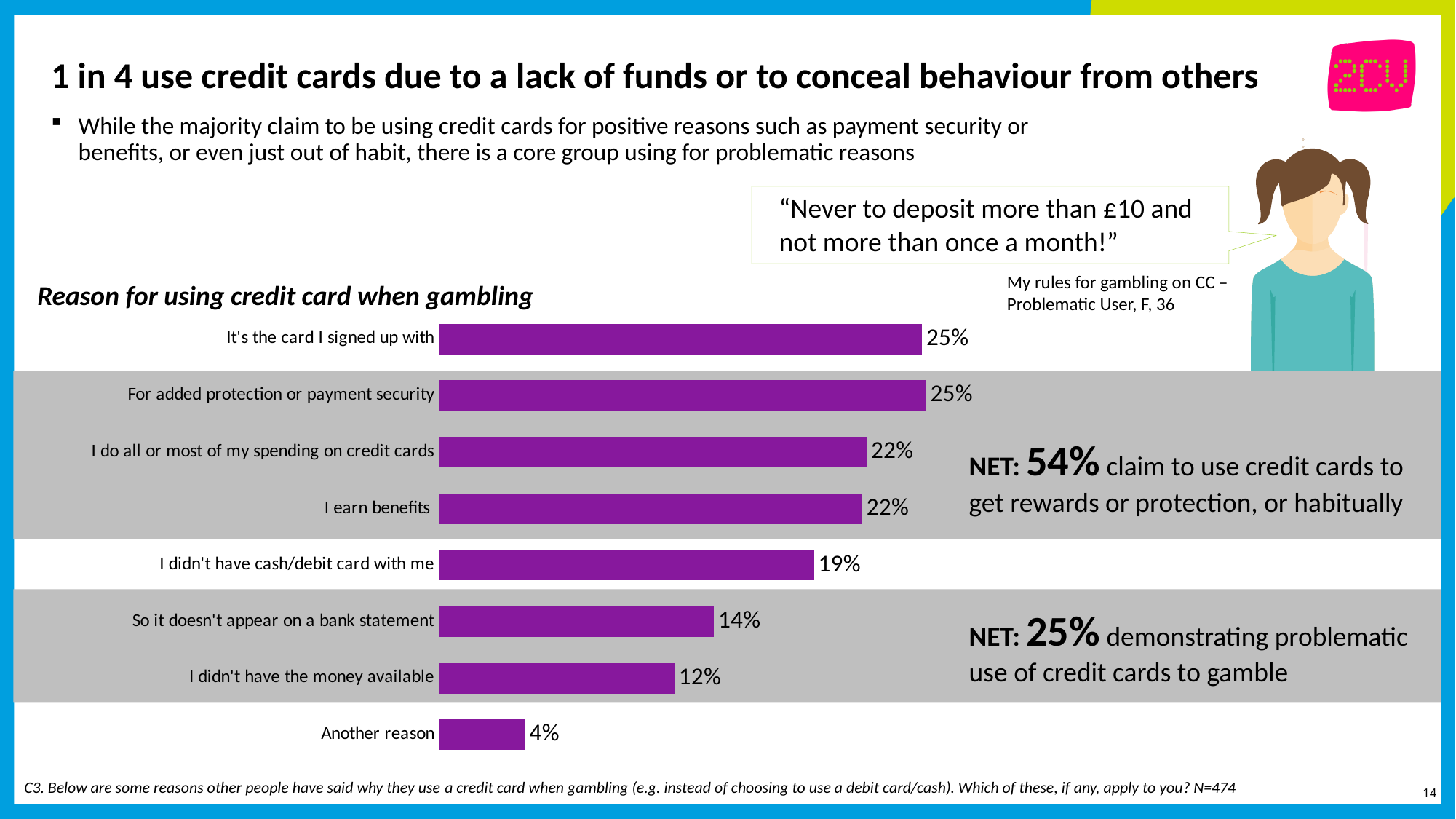
What is the value for 'I didn't have the money available'? 12% What is the difference between 'For added protection or payment security' and 'I didn't have the money available'? 13% What is the value for 'I didn't have cash/debit card with me'? 19% Which reason has the lowest percentage in the chart? Another reason What type of chart is used to show the reasons for using a credit card when gambling? Bar chart What is the difference between 'I earn benefits' and 'Another reason'? 18% What colour are the bars in the chart? Purple What is the title of the chart? Reason for using credit card when gambling Which is larger: 'I do all or most of my spending on credit cards' or 'So it doesn't appear on a bank statement'? I do all or most of my spending on credit cards How many reasons are listed in the chart? 8 What percentage chose 'So it doesn't appear on a bank statement'? 14% What percentage of respondents said they use a credit card when gambling because it's the card they signed up with? 25%